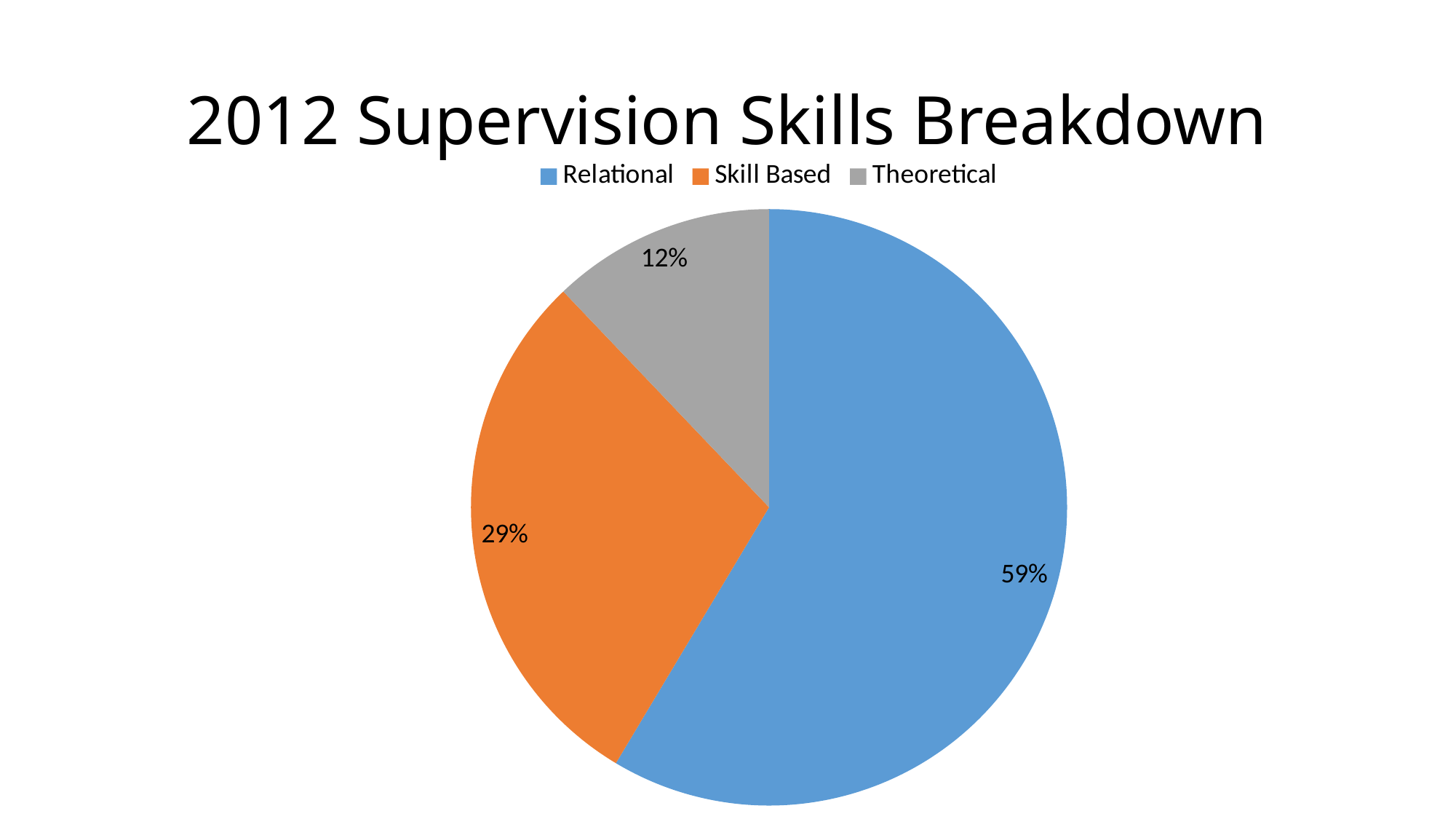
Which colour represents Skill Based in the legend? Orange What is the difference in percentage points between the Relational and Skill Based slices? 30 What is the title of the chart? 2012 Supervision Skills Breakdown How many slices does the pie chart have? 3 What is the difference in percentage points between the Skill Based and Theoretical slices? 17 Which category has the largest slice of the pie? Relational What share of the pie does Theoretical account for? 12% Which is larger, the Skill Based slice or the Theoretical slice? Skill Based What kind of chart is shown on the slide? Pie chart Which category has the smallest slice of the pie? Theoretical What share of the pie does Relational account for? 59% What share of the pie does Skill Based account for? 29%